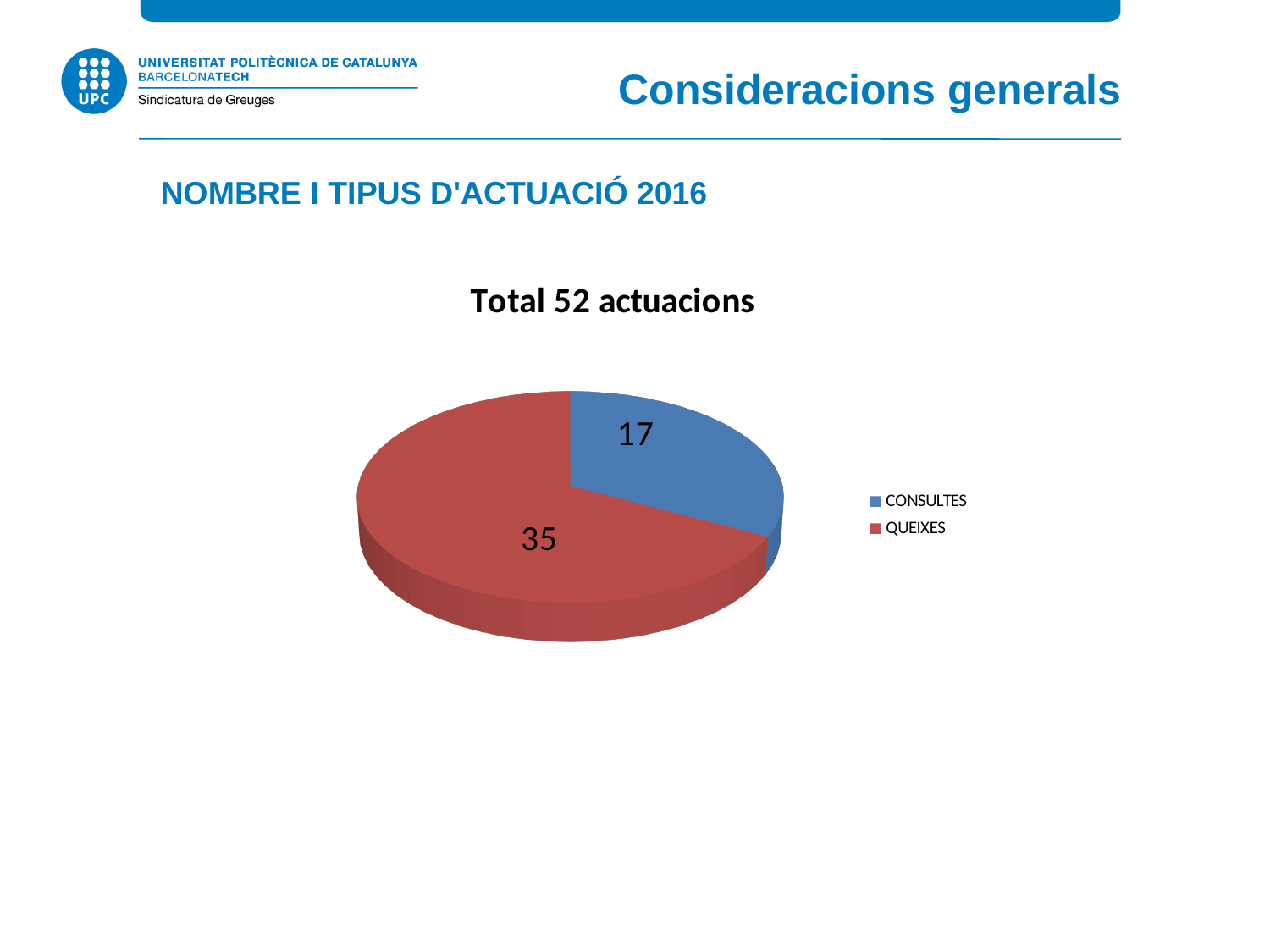
Which category has the largest slice of the pie? QUEIXES How many categories does the pie chart show? 2 What is the difference between the values for QUEIXES and CONSULTES? 18 What is the value for CONSULTES? 17 Which category has the smallest slice of the pie? CONSULTES Which is larger, CONSULTES or QUEIXES? QUEIXES What is the value for QUEIXES? 35 What colour is the QUEIXES slice? Red What is the total of the two slices in the pie chart? 52 What kind of chart is shown on the slide? Pie chart What is the title of the chart? Total 52 actuacions